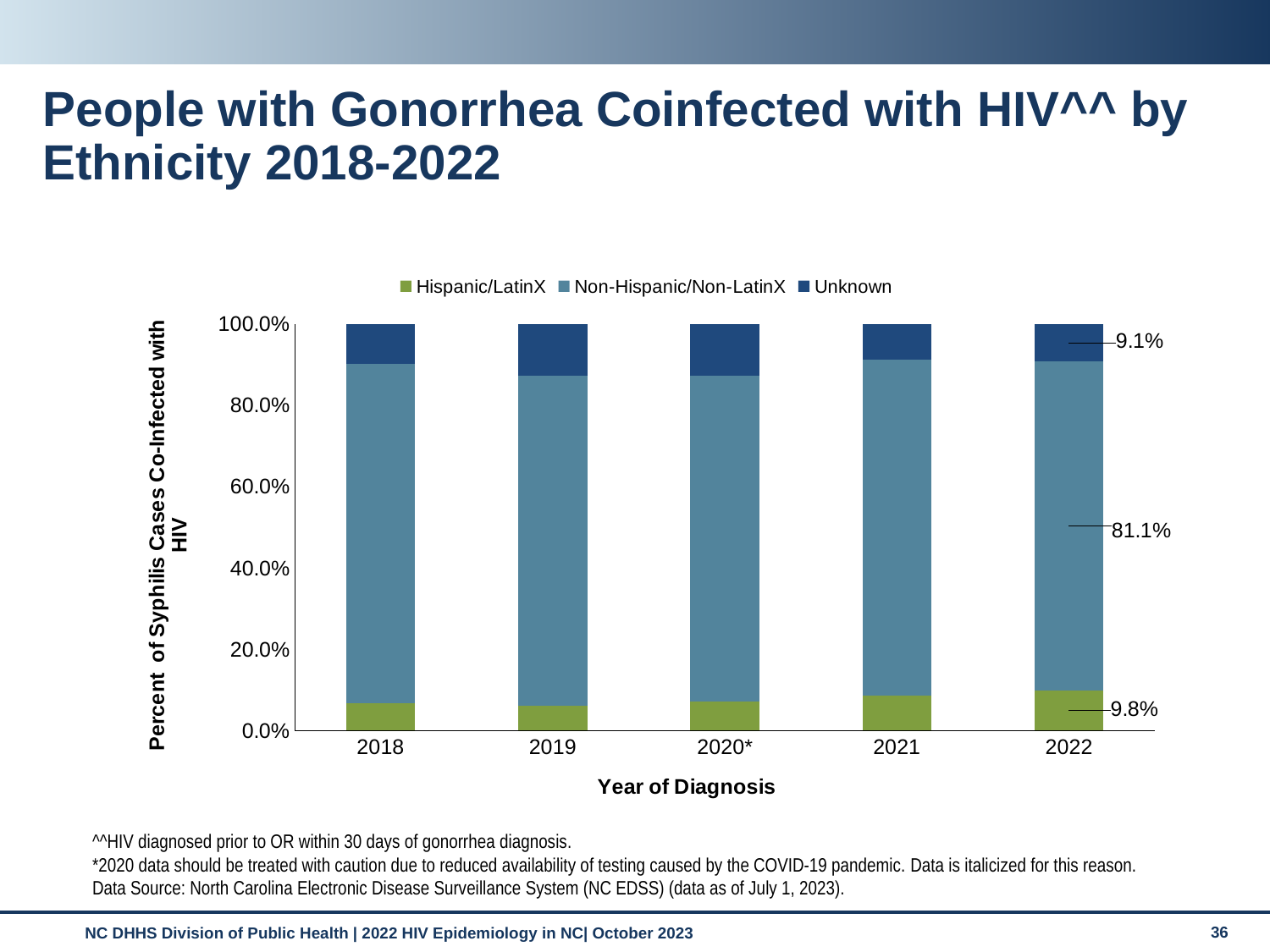
What percentage of the 2022 bar is Non-Hispanic/Non-LatinX? 81.1% What kind of chart is shown on the slide? Stacked bar chart What is the title of the x axis? Year of Diagnosis In 2022, which is larger: the Hispanic/LatinX share or the Unknown share? Hispanic/LatinX What percentage of the 2022 bar is Unknown? 9.1% In 2022, what is the difference between the Non-Hispanic/Non-LatinX share and the Hispanic/LatinX share? 71.3 percentage points Is the Unknown share in 2019 greater or less than 20%? less What percentage of the 2022 bar is Hispanic/LatinX? 9.8% How many series does the legend list? 3 What is the total of the three labelled segments in the 2022 bar? 100.0% How many years are shown on the x axis? 5 Is the Hispanic/LatinX share in 2018 greater or less than 20%? less